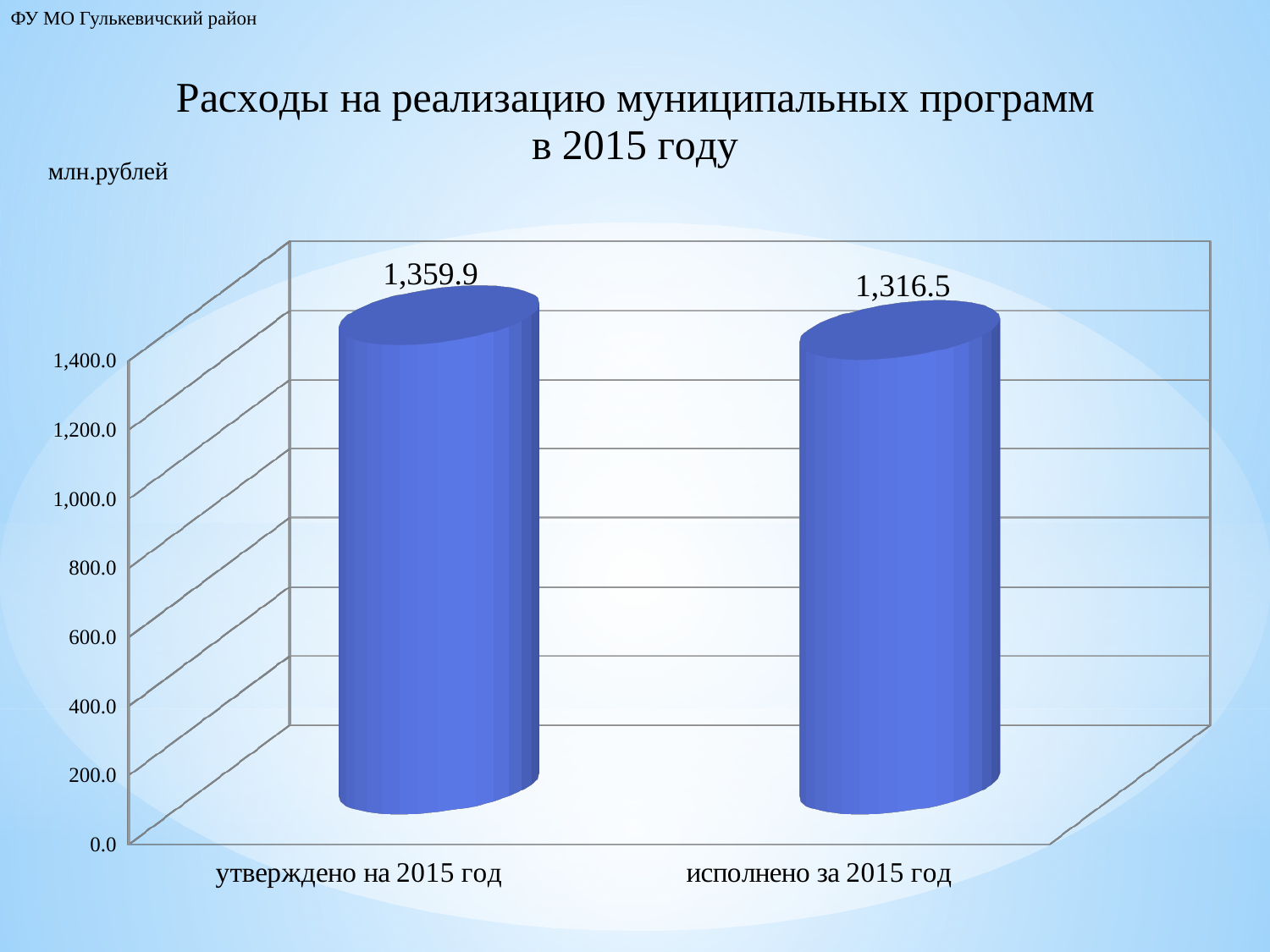
What unit is indicated for the values on the chart? млн.рублей Which category has the highest value? утверждено на 2015 год Do the values rise or fall from left to right along the x axis? fall Is the value for 'исполнено за 2015 год' greater or less than 1,200.0? greater Which category has the lowest value? исполнено за 2015 год Which is larger: the value for 'утверждено на 2015 год' or the value for 'исполнено за 2015 год'? утверждено на 2015 год What is the value for 'утверждено на 2015 год'? 1,359.9 What is the title of the chart? Расходы на реализацию муниципальных программ в 2015 году How many categories are shown on the x axis? 2 What is the value for 'исполнено за 2015 год'? 1,316.5 What kind of chart is shown on the slide? bar chart What is the difference between the value for 'утверждено на 2015 год' and the value for 'исполнено за 2015 год'? 43.4